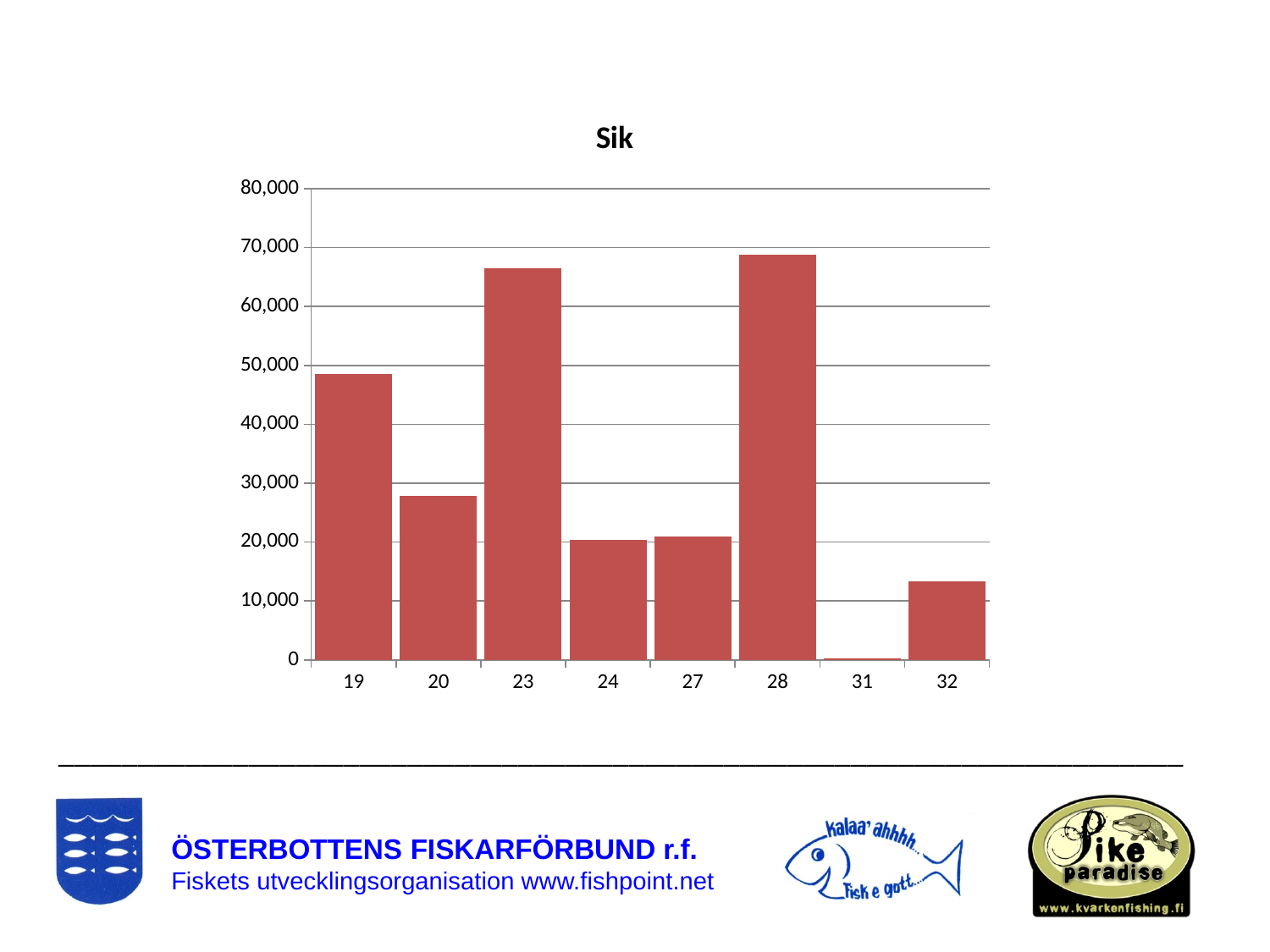
What is the title of the chart? Sik Which is larger, the value for category 19 or the value for category 20? 19 Is the value for category 20 greater or less than 30,000? less Is the value for category 23 greater or less than 60,000? greater What kind of chart is shown on the slide? bar chart What colour are the bars in the chart? red Which category has the lowest bar in the chart? 31 Is the value for category 32 greater or less than 10,000? greater How many categories are shown on the x axis of the chart? 8 Which category has the highest bar in the chart? 28